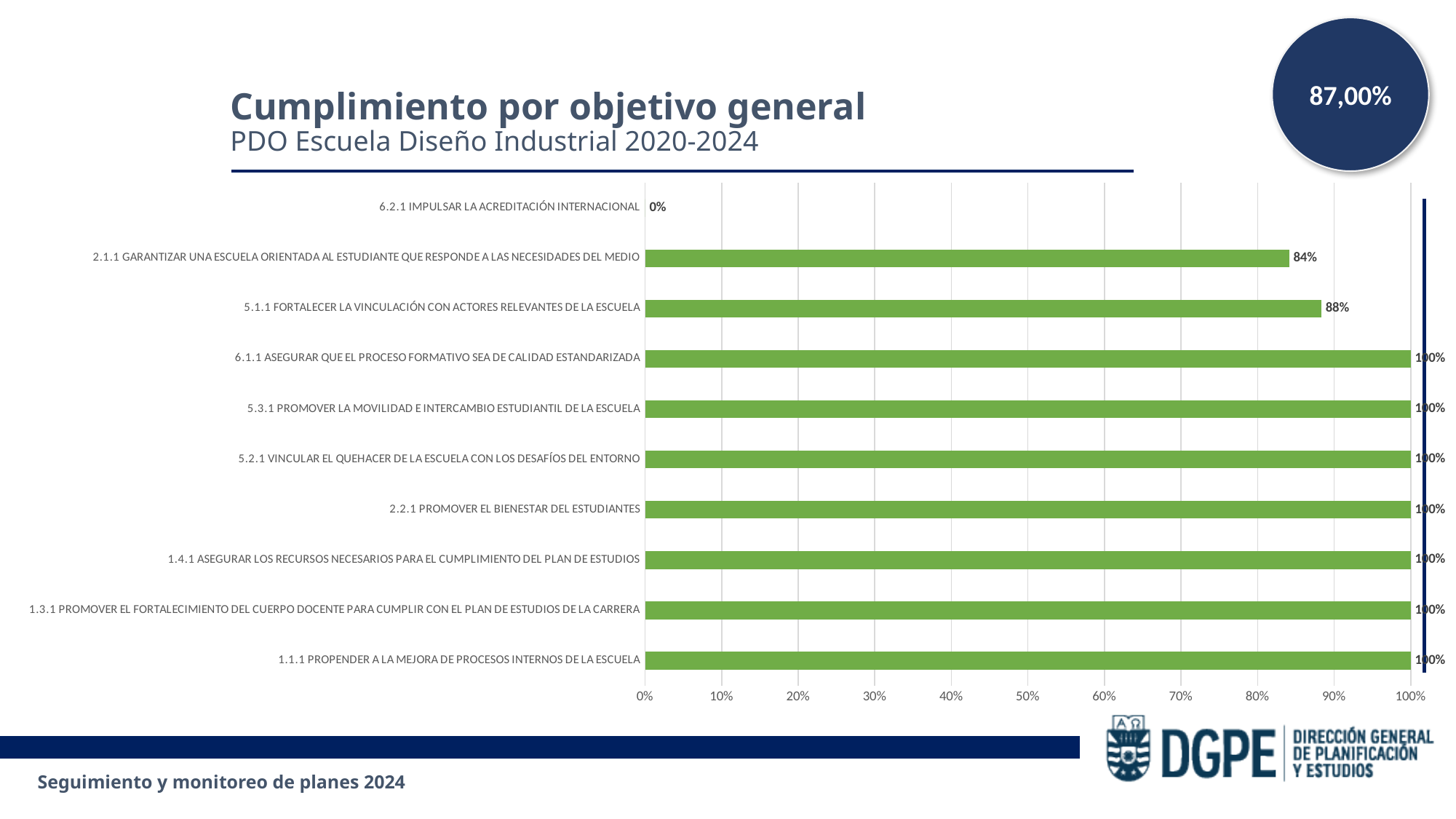
What is the value for 5.1.1 FORTALECER LA VINCULACIÓN CON ACTORES RELEVANTES DE LA ESCUELA? 88% How many categories have a value of 100%? 7 What is the value for 2.1.1 GARANTIZAR UNA ESCUELA ORIENTADA AL ESTUDIANTE QUE RESPONDE A LAS NECESIDADES DEL MEDIO? 84% What is the value for 1.1.1 PROPENDER A LA MEJORA DE PROCESOS INTERNOS DE LA ESCUELA? 100% What is the title of the chart? Cumplimiento por objetivo general What kind of chart is shown on the slide? bar chart What is the difference between the values for 5.1.1 FORTALECER LA VINCULACIÓN CON ACTORES RELEVANTES DE LA ESCUELA and 2.1.1 GARANTIZAR UNA ESCUELA ORIENTADA AL ESTUDIANTE QUE RESPONDE A LAS NECESIDADES DEL MEDIO? 4% Which is larger: the value for 5.1.1 FORTALECER LA VINCULACIÓN CON ACTORES RELEVANTES DE LA ESCUELA or the value for 2.1.1 GARANTIZAR UNA ESCUELA ORIENTADA AL ESTUDIANTE QUE RESPONDE A LAS NECESIDADES DEL MEDIO? 5.1.1 FORTALECER LA VINCULACIÓN CON ACTORES RELEVANTES DE LA ESCUELA Which category has the lowest value? 6.2.1 IMPULSAR LA ACREDITACIÓN INTERNACIONAL What is the value for 6.2.1 IMPULSAR LA ACREDITACIÓN INTERNACIONAL? 0% Is the value for 2.1.1 GARANTIZAR UNA ESCUELA ORIENTADA AL ESTUDIANTE QUE RESPONDE A LAS NECESIDADES DEL MEDIO greater or less than 90%? less How many categories are shown in the chart? 10